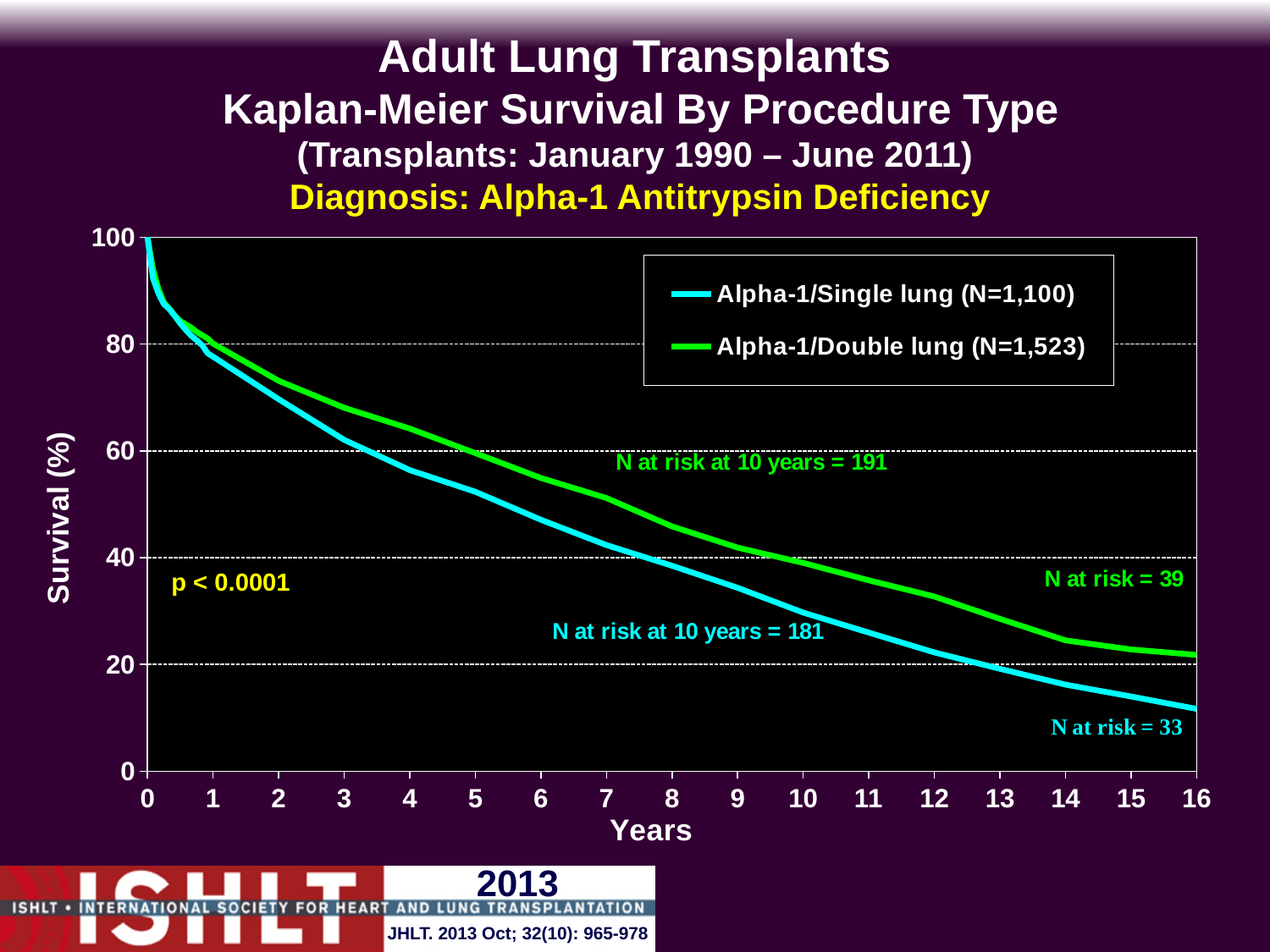
What is the N at risk shown at the end of the Alpha-1/Double lung curve? 39 What is the difference between the N at risk at 10 years for the Double lung group and the Single lung group? 10 What is the N given in the legend for the Alpha-1/Double lung group? N=1,523 What is the N at risk at 10 years for the Alpha-1/Double lung group? 191 Which group has the higher survival at 10 years, Alpha-1/Single lung or Alpha-1/Double lung? Alpha-1/Double lung What is the N at risk shown at the end of the Alpha-1/Single lung curve? 33 What kind of chart is shown on the slide? Line chart Do the survival curves rise or fall as years increase? Fall Is the survival for Alpha-1/Single lung at 5 years greater or less than 60? less Is the survival for Alpha-1/Single lung at 16 years greater or less than 20? less What is the N at risk at 10 years for the Alpha-1/Single lung group? 181 How many series does the legend list? 2